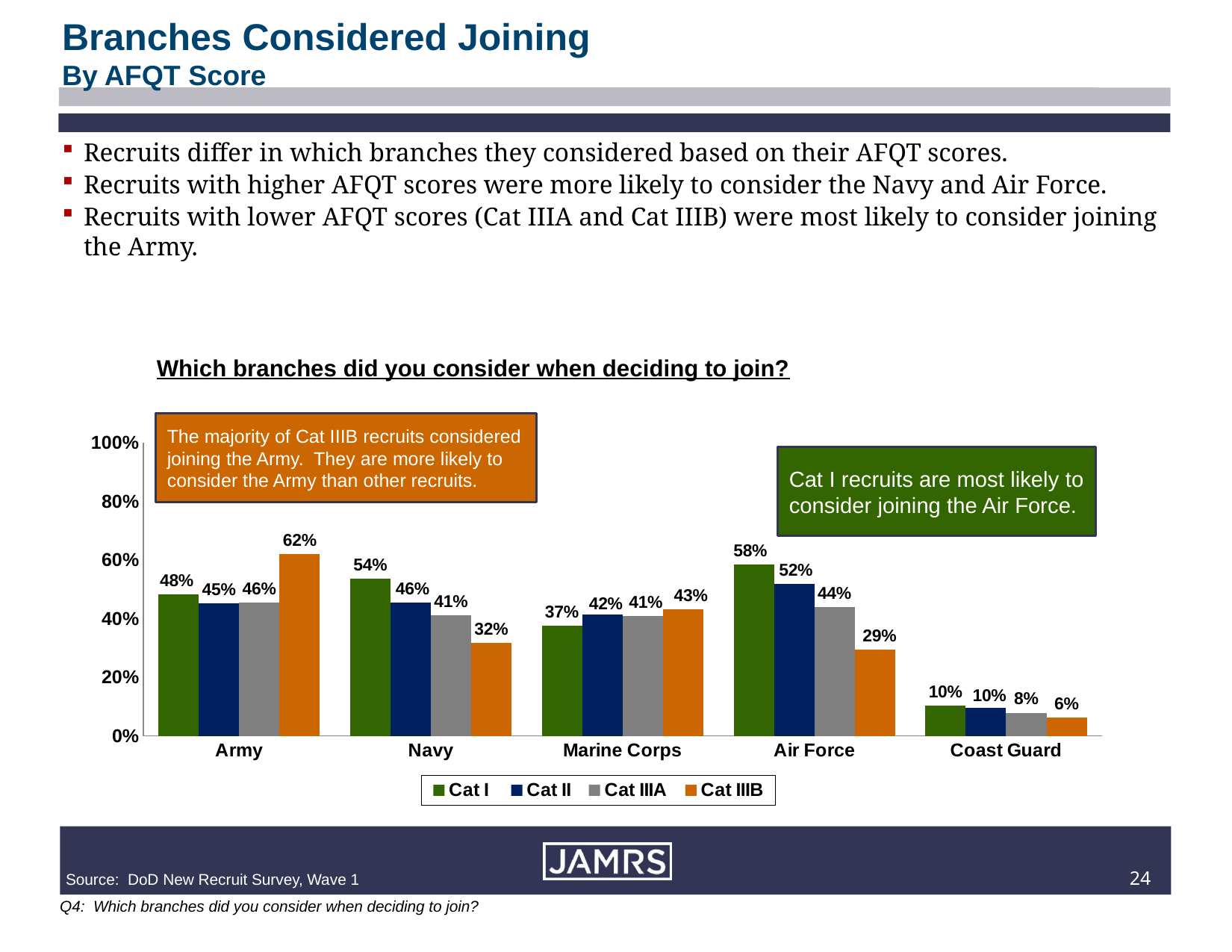
How many series does the chart legend list? 4 What percentage of Cat I recruits considered joining the Air Force? 58% What colour are the Cat IIIB bars in the chart? Orange What kind of chart is shown on the slide? Bar chart What is the difference between the Cat I and Cat IIIB values for the Air Force? 29% What is the difference between the Cat I and Cat IIIB values for the Navy? 22% Which branch has the lowest value for Cat IIIB recruits? Coast Guard Which is larger for the Marine Corps: the Cat I value or the Cat IIIB value? Cat IIIB How many branches are shown on the x axis of the chart? 5 What percentage of Cat IIIB recruits considered joining the Army? 62% What percentage of Cat IIIA recruits considered joining the Navy? 41% Which AFQT category has the highest value for the Navy? Cat I